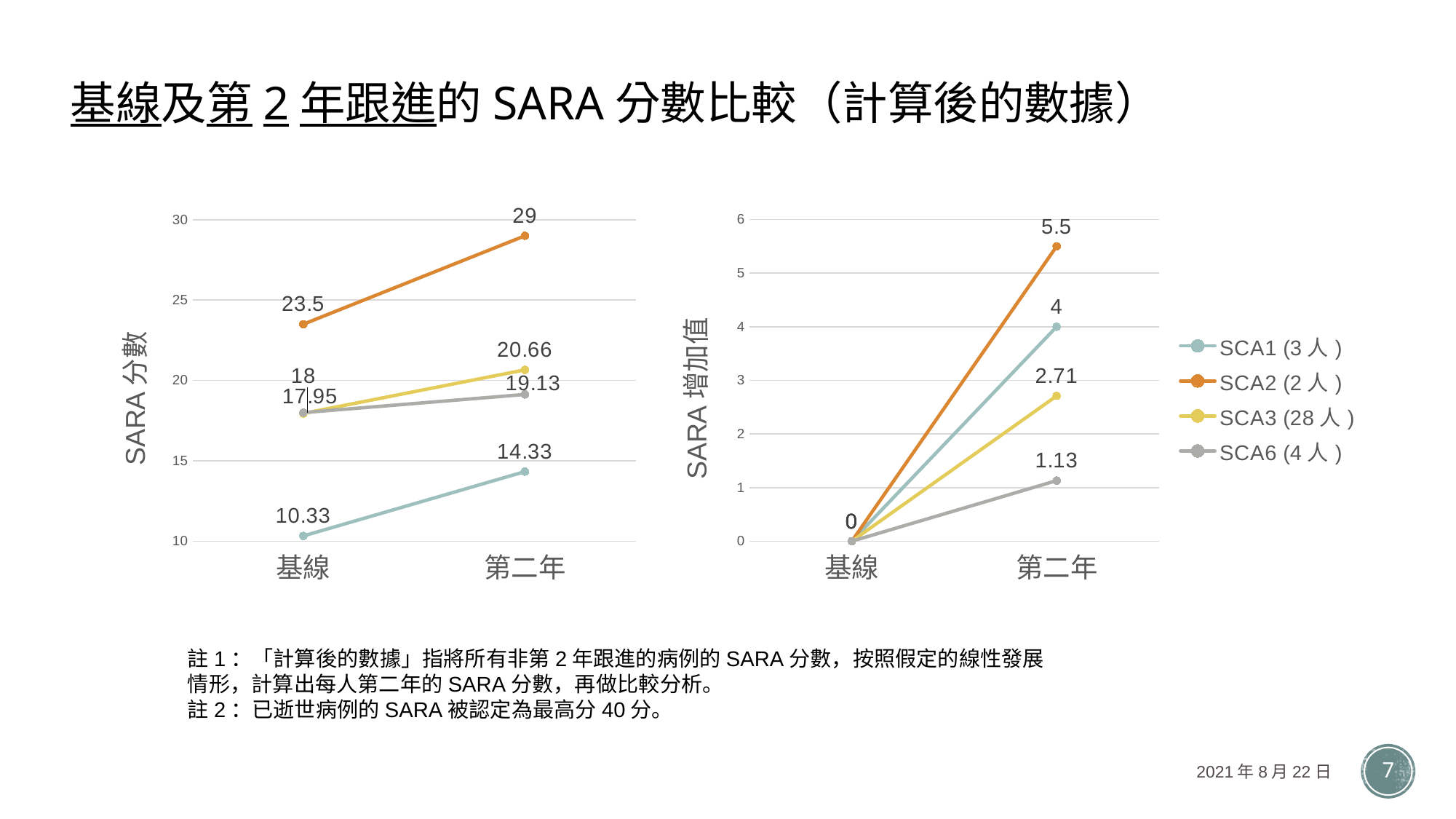
In the right chart (SARA 增加值), which is larger at 第二年: SCA1 (3 人) or SCA3 (28 人)? SCA1 (3 人) In the right chart (SARA 增加值), what is the value for SCA6 (4 人) at 第二年? 1.13 In the left chart (SARA 分數), what is the value for SCA1 (3 人) at 基線? 10.33 How many series does the legend list? 4 In the right chart (SARA 增加值), what is the value for all series at 基線? 0 In the left chart (SARA 分數), what is the value for SCA2 (2 人) at 第二年? 29 In the left chart (SARA 分數), what is the value for SCA3 (28 人) at 第二年? 20.66 In the left chart (SARA 分數), what is the difference between the 第二年 and 基線 values for SCA2 (2 人)? 5.5 What kind of chart is the left chart (SARA 分數)? line chart In the left chart (SARA 分數), does the value for SCA6 (4 人) rise or fall from 基線 to 第二年? rise In the right chart (SARA 增加值), which series has the highest value at 第二年? SCA2 (2 人) In the left chart (SARA 分數), which series has the lowest value at 基線? SCA1 (3 人)